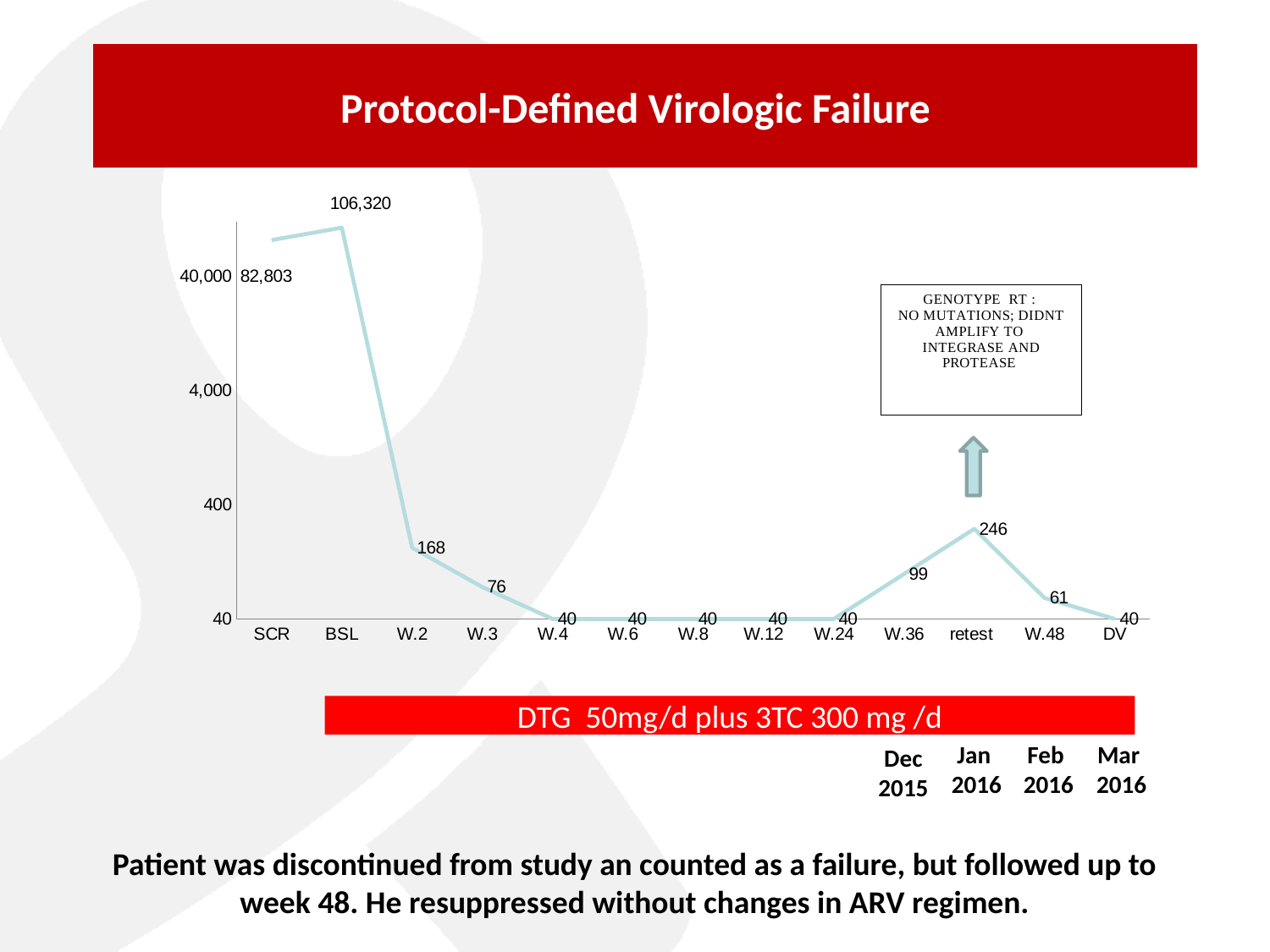
What is the difference between the values at retest and W.36? 147 What is the value at retest? 246 How many categories are shown on the x axis? 13 What is the value at BSL? 106,320 What kind of chart is shown on the slide? Line chart What is the difference between the values at BSL and SCR? 23,517 Which is larger, the value at W.3 or the value at W.36? W.36 What is the value at W.48? 61 Which category has the highest value? BSL What is the value at SCR? 82,803 Do the values rise or fall from BSL to W.4? Fall What is the value at W.2? 168